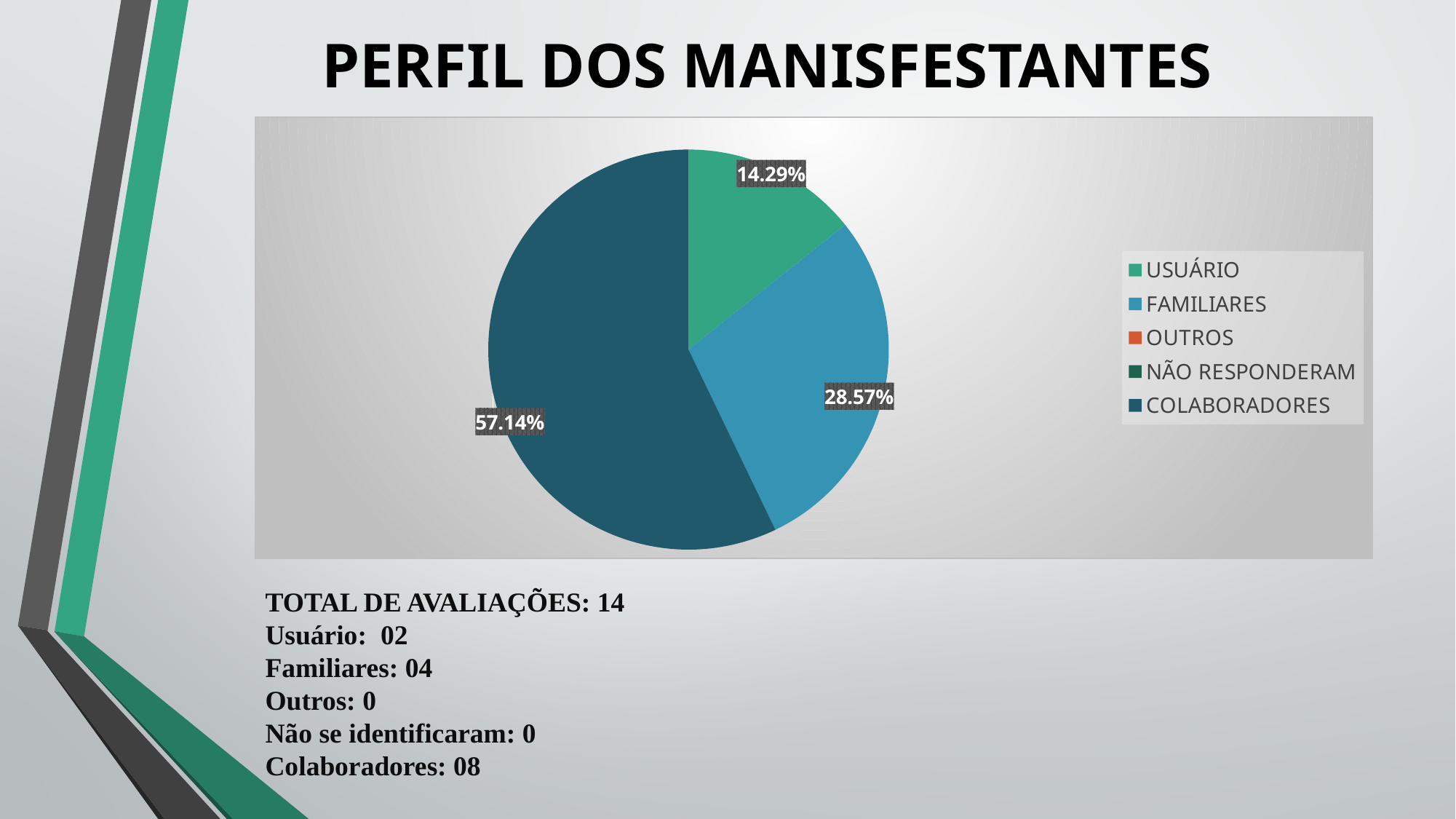
What kind of chart is shown on the slide? pie chart Which category has the largest slice of the pie? COLABORADORES What is the difference in percentage points between the COLABORADORES slice and the FAMILIARES slice? 28.57 What share of the pie does the FAMILIARES slice represent? 28.57% What share of the pie does the USUÁRIO slice represent? 14.29% What share of the pie does the COLABORADORES slice represent? 57.14% What colour is the COLABORADORES slice in the legend? dark teal Is the COLABORADORES slice more or less than half of the pie? more How many slices are visible in the pie chart? 3 Which slice is larger, FAMILIARES or USUÁRIO? FAMILIARES Which of the visible slices is the smallest? USUÁRIO How many entries does the legend list? 5